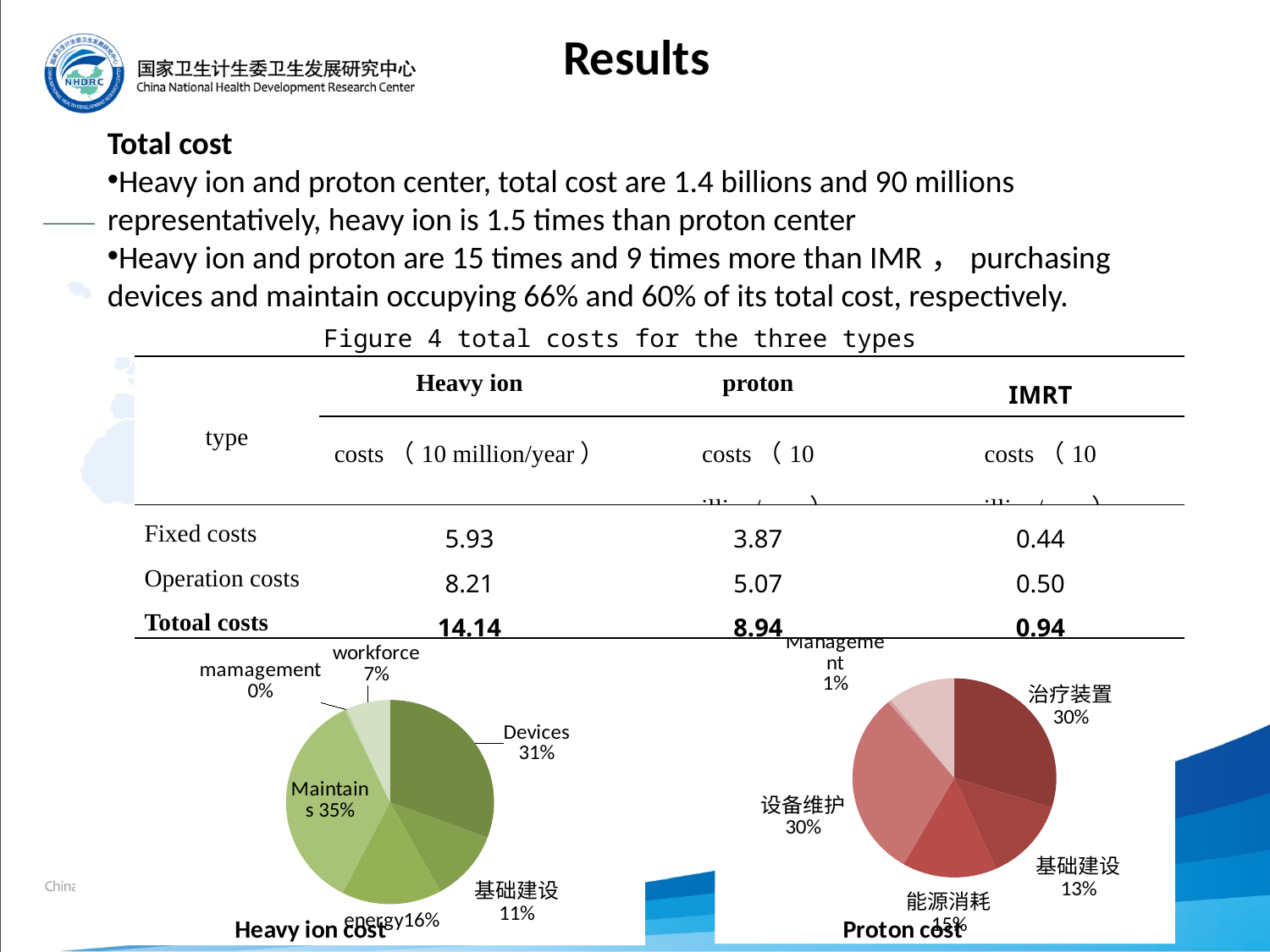
What type of chart is used for the Heavy ion cost and Proton cost figures? Pie chart In the Heavy ion cost pie chart, which labelled category has the smallest share? mamagement In the Proton cost pie chart, what share does 基础建设 account for? 13% In the Heavy ion cost pie chart, what is the difference between the Maintains share and the Devices share? 4% In the Proton cost pie chart, which is larger, the share for 能源消耗 or the share for 基础建设? 能源消耗 In the Heavy ion cost pie chart, what share does energy account for? 16% In the Proton cost pie chart, what share does Management account for? 1% In the Heavy ion cost pie chart, what share does Devices account for? 31% In the Heavy ion cost pie chart, what share does workforce account for? 7% In the Heavy ion cost pie chart, what share does Maintains account for? 35% In the Heavy ion cost pie chart, which labelled category has the largest share? Maintains In the Proton cost pie chart, what share does 治疗装置 account for? 30%